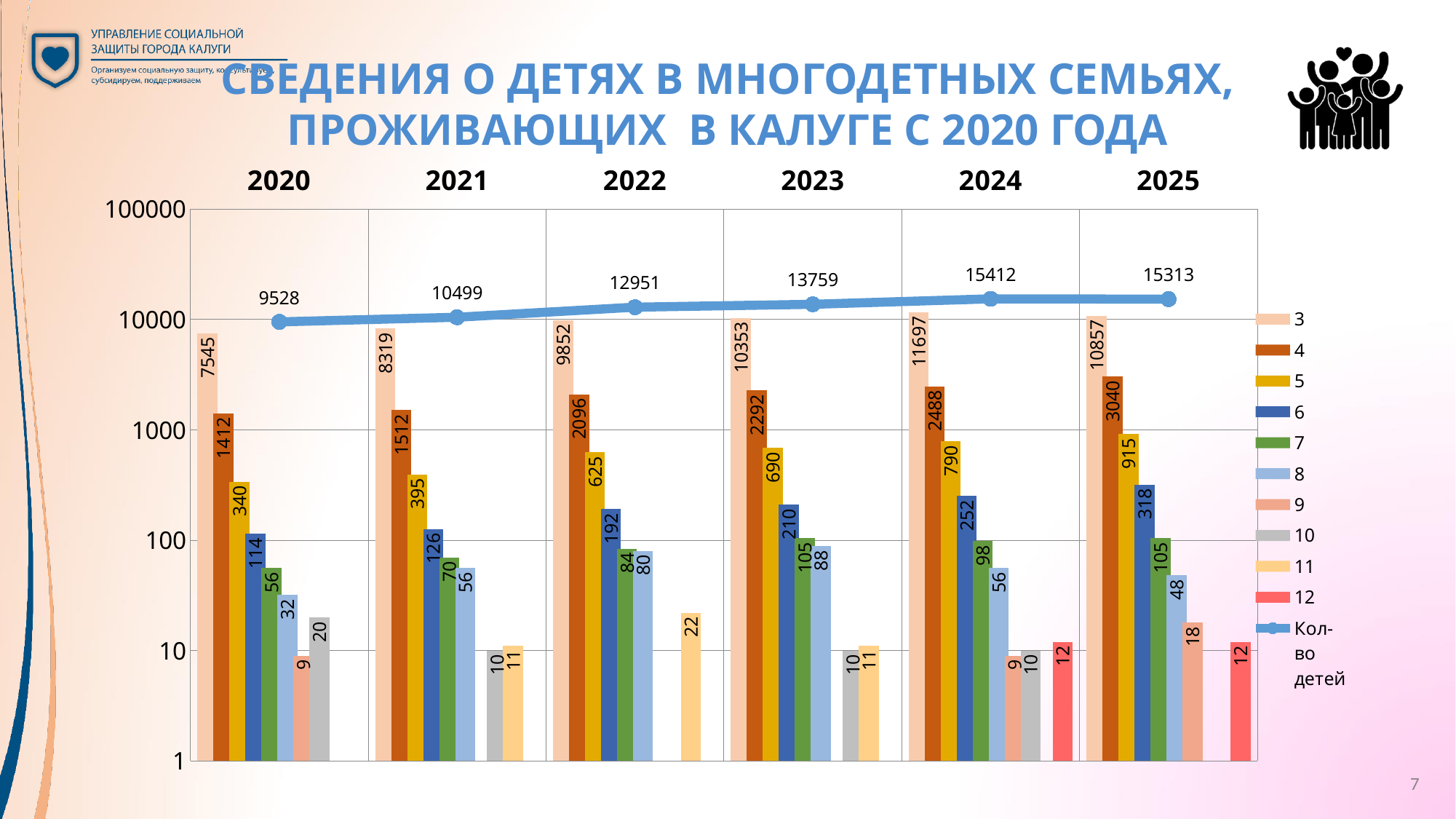
In which year does the 'Кол-во детей' line reach its highest value? 2024 How many years are shown on the x axis? 6 What is the value of series '4' in 2025? 3040 How many entries does the legend list? 11 What is the value of series '3' in 2024? 11697 What is the value of the 'Кол-во детей' line for 2022? 12951 Which is larger: series '5' in 2022 or series '5' in 2023? 2023 What is the difference between the values of series '4' in 2025 and 2024? 552 What is the difference between the 'Кол-во детей' values for 2024 and 2025? 99 Does the 'Кол-во детей' line rise or fall from 2020 to 2024? rise What is the value of series '6' in 2023? 210 In which year is the 'Кол-во детей' line at its lowest value? 2020